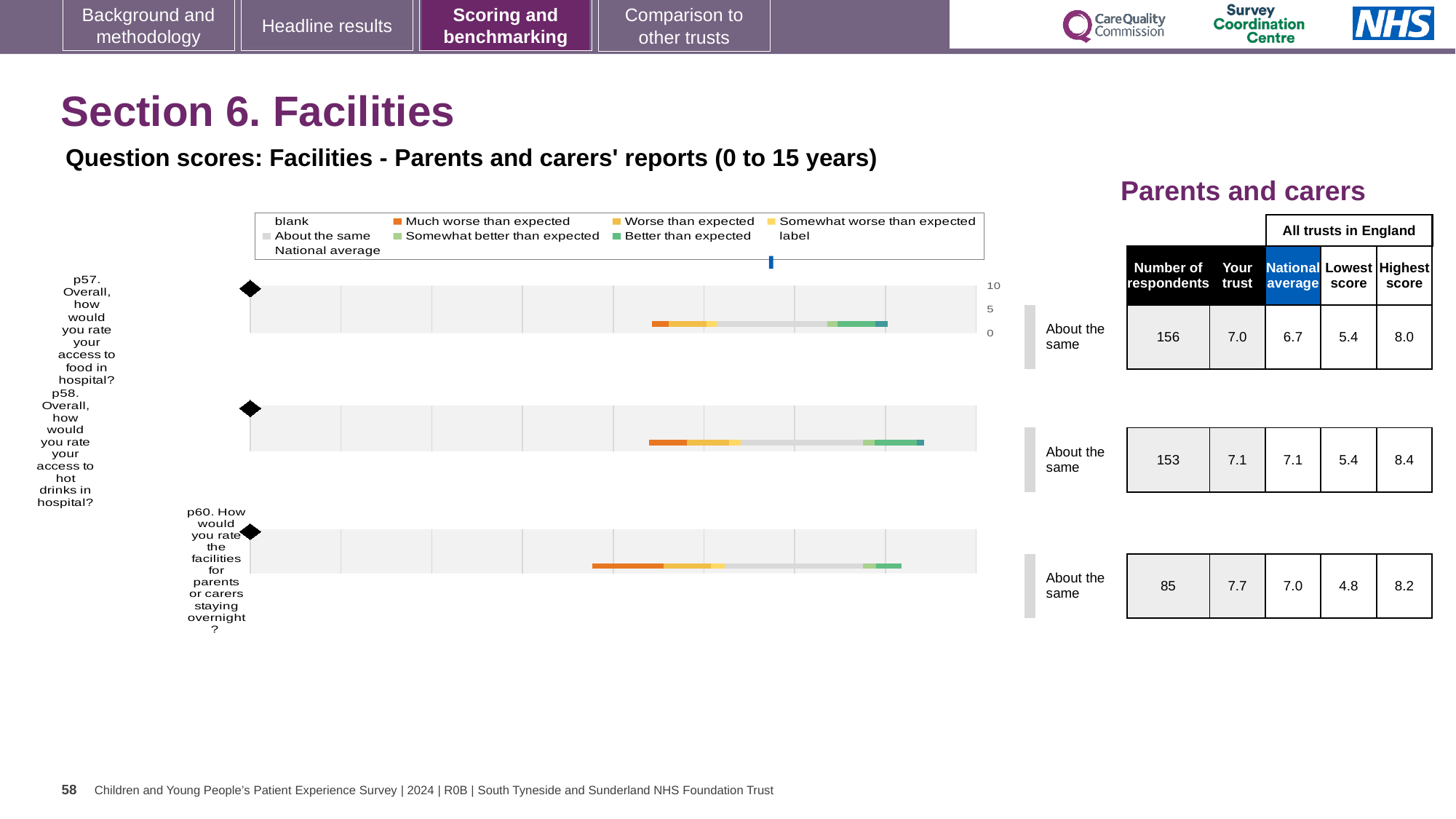
What benchmark category is shown next to the p58 bar? About the same What kind of chart is shown on the slide? bar chart In the chart legend, which category is shown in orange? Much worse than expected In the table beside the chart, what is the 'Your trust' score for p60 (facilities for parents or carers staying overnight)? 7.7 Which question has the lowest 'Lowest score' value in the table beside the chart? p60 (facilities for parents or carers staying overnight) In the table beside the chart, how many respondents are listed for p57 (access to food in hospital)? 156 For p57, is the 'Your trust' score or the national average larger? Your trust Which of the three questions has the highest 'Your trust' score in the table beside the chart? p60 (facilities for parents or carers staying overnight) In the table beside the chart, what is the national average for p58 (access to hot drinks in hospital)? 7.1 What is the heading above the chart? Question scores: Facilities - Parents and carers' reports (0 to 15 years) For p60, what is the difference between the highest score and the lowest score in the table? 3.4 How many survey questions (bars) are plotted in the chart? 3